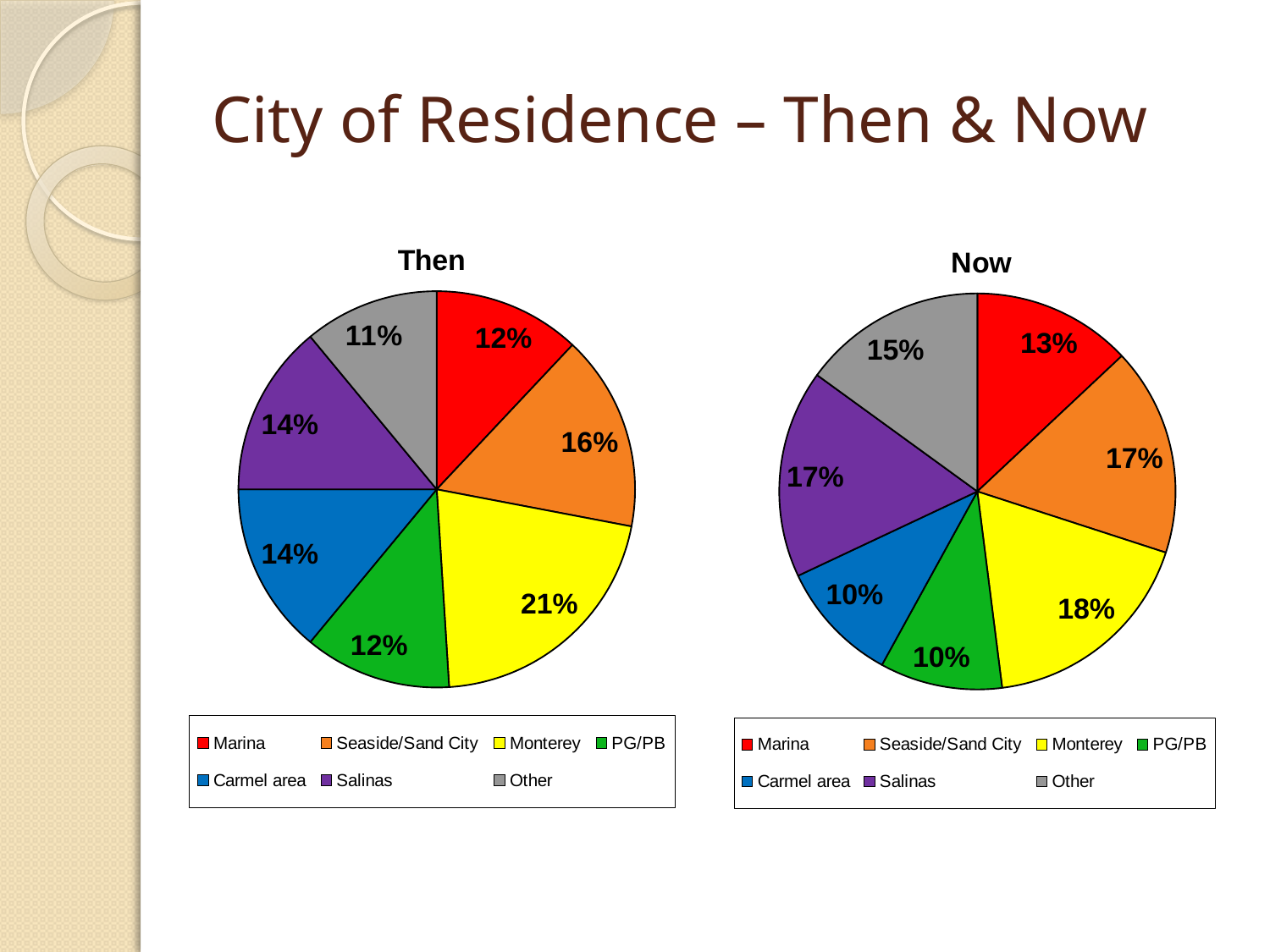
In the "Now" pie chart, what share does Salinas have? 17% How many slices does the "Now" pie chart have? 7 In the "Then" pie chart, which is larger, the share for Seaside/Sand City or the share for Marina? Seaside/Sand City In the "Then" pie chart, which city has the largest share? Monterey What type of chart is used for "Then" and "Now"? Pie chart In the "Then" pie chart, which city has the smallest share? Other In the "Now" pie chart, what share does Carmel area have? 10% In the "Then" pie chart, what share does Other have? 11% In the "Now" pie chart, which city has the largest share? Monterey In the "Then" pie chart, what share does Monterey have? 21% In the "Then" pie chart, what colour is the Salinas slice? Purple In the "Now" pie chart, what is the difference between the Monterey share and the Other share? 3%